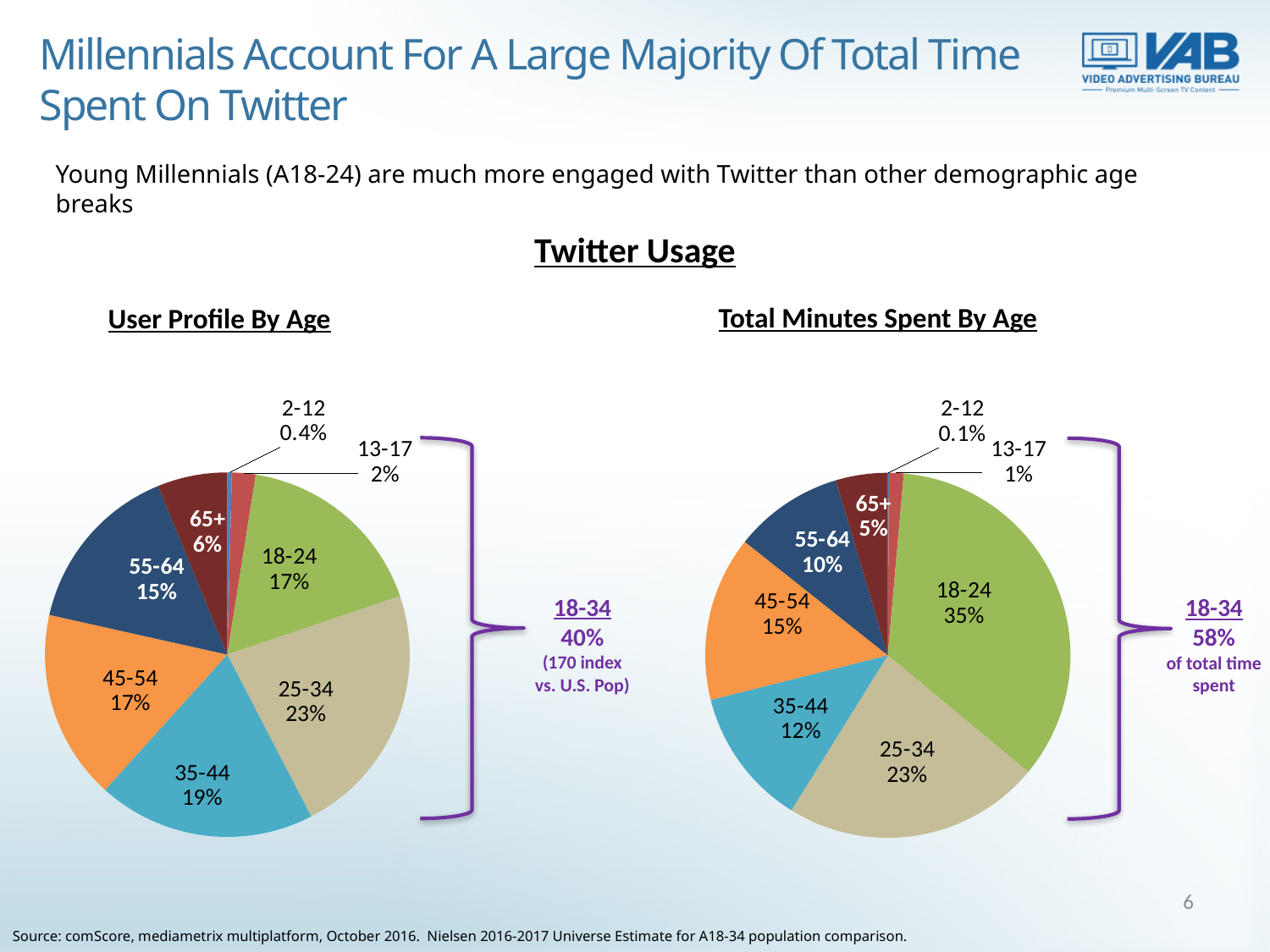
In the 'Total Minutes Spent By Age' pie chart, which age group has the largest share? 18-24 In the 'Total Minutes Spent By Age' pie chart, what share is shown for the 55-64 age group? 10% In the 'User Profile By Age' pie chart, what is the difference between the 35-44 share and the 65+ share? 13% In the 'User Profile By Age' pie chart, what share is shown for the 25-34 age group? 23% What is the overall heading above the two pie charts? Twitter Usage How many age groups are shown in the 'User Profile By Age' pie chart? 8 In the 'User Profile By Age' pie chart, what share is shown for the 13-17 age group? 2% In the 'Total Minutes Spent By Age' pie chart, which is larger: the 45-54 share or the 35-44 share? 45-54 In the 'Total Minutes Spent By Age' pie chart, what share is shown for the 18-24 age group? 35% What type of chart is used for 'Total Minutes Spent By Age'? Pie chart In the 'User Profile By Age' pie chart, which age group has the smallest share? 2-12 In the 'User Profile By Age' pie chart, what is the combined share of the 18-24 and 25-34 groups? 40%